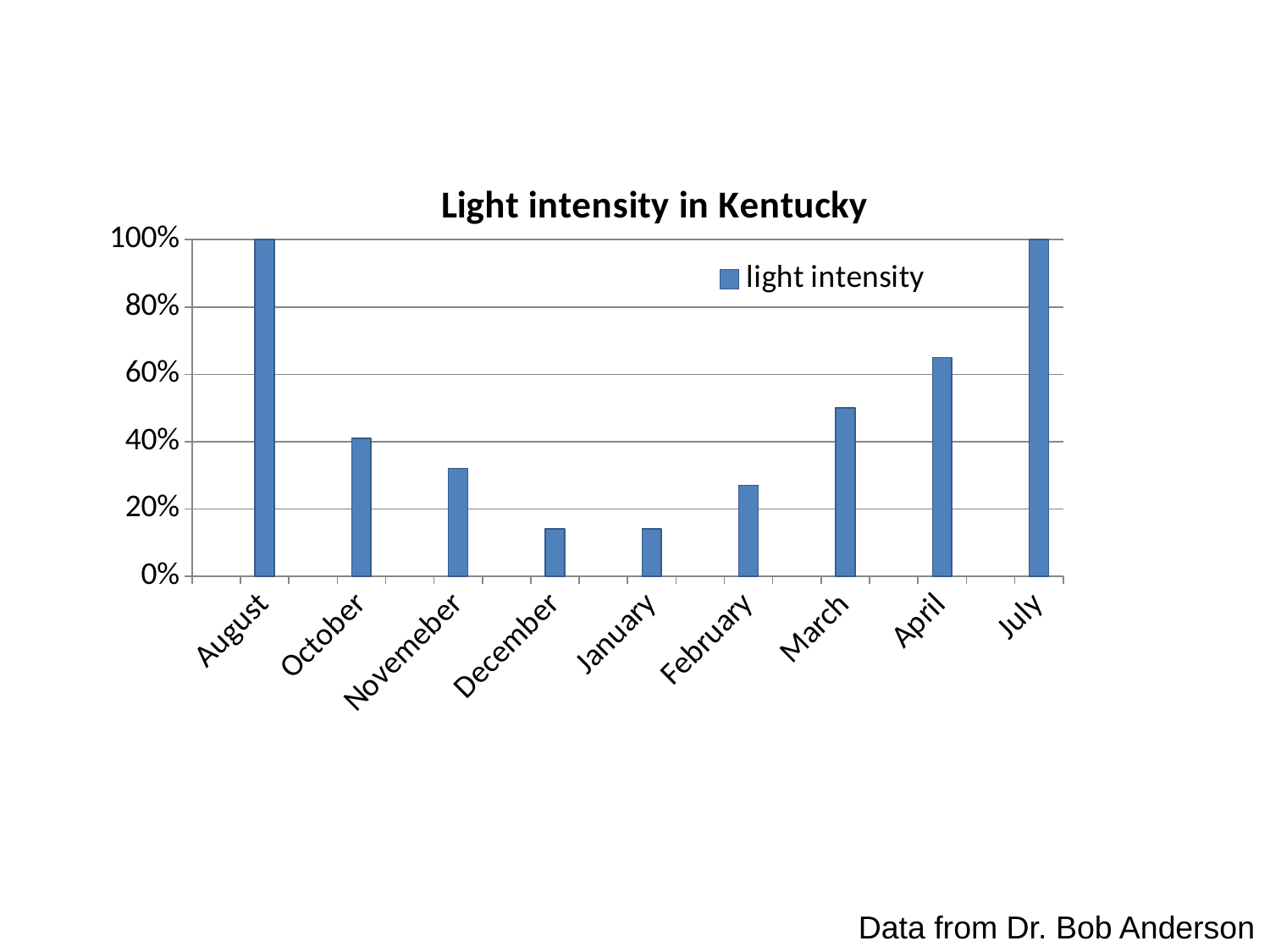
How many months are shown on the x axis? 9 How many series does the legend list? 1 Which has the larger value, October or November? October Do the values rise or fall from January through July? rise What is the title of the chart? Light intensity in Kentucky Is the value for November greater or less than 40%? less Is the value for December greater or less than 20%? less Is the value for March greater or less than 40%? greater What is the light intensity value for July? 100% What kind of chart is shown on the slide? bar chart What is the light intensity value for August? 100%